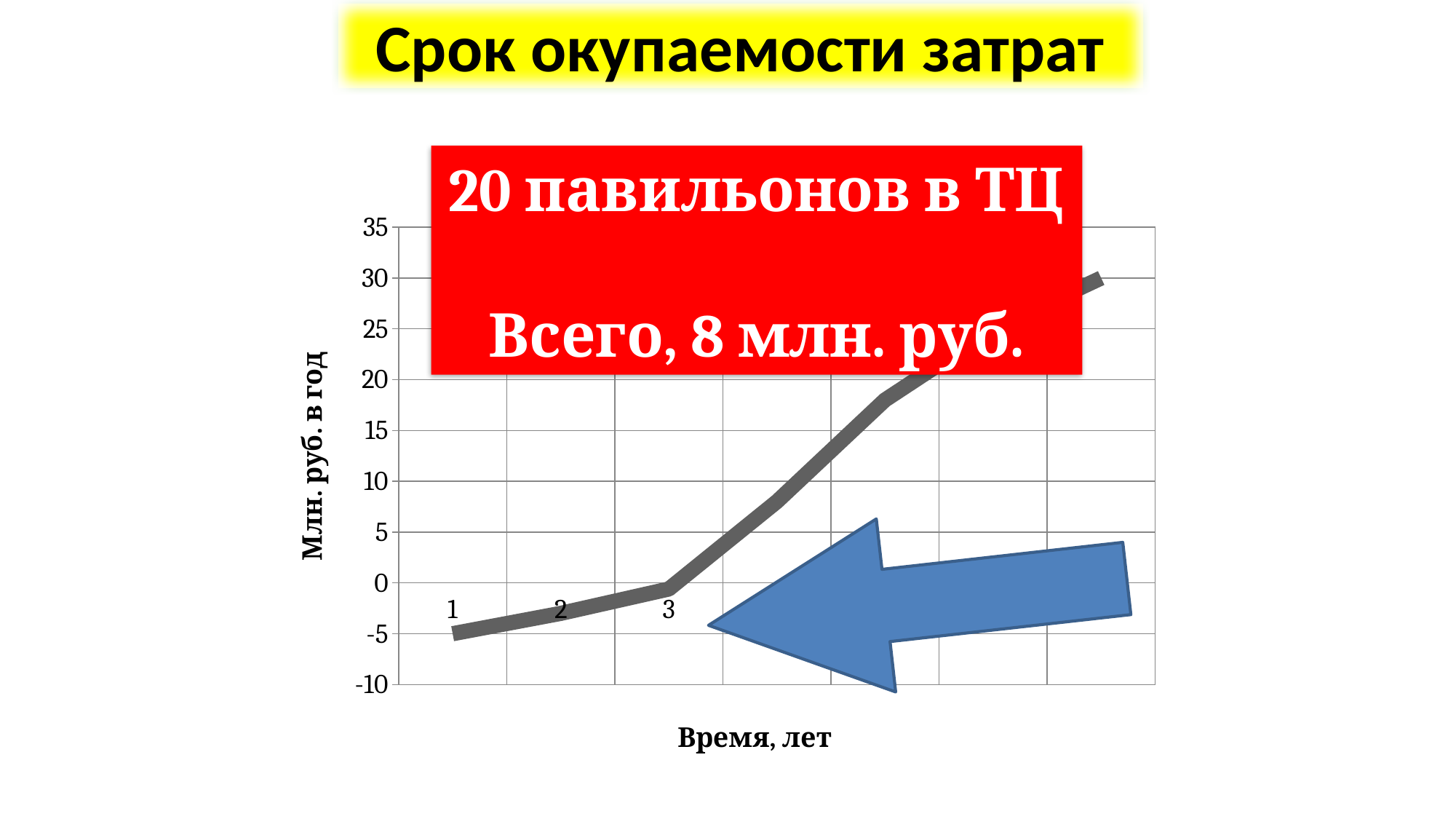
Which is larger, the value for year 1 or the value for year 2? year 2 Is the value for year 1 greater or less than 5? less What is the title of the slide above the chart? Срок окупаемости затрат What is the label of the vertical axis of the chart? Млн. руб. в год Is the value for year 2 greater or less than 0? less Do the values on the chart rise or fall as time (years) increases along the x axis? rise What is the highest tick value shown on the vertical axis? 35 Which is larger, the value for year 1 or the value for year 3? year 3 Is the value for year 1 greater or less than 0? less What kind of chart is shown on the slide? line chart Of the years labelled 1, 2 and 3, which has the lowest value? 1